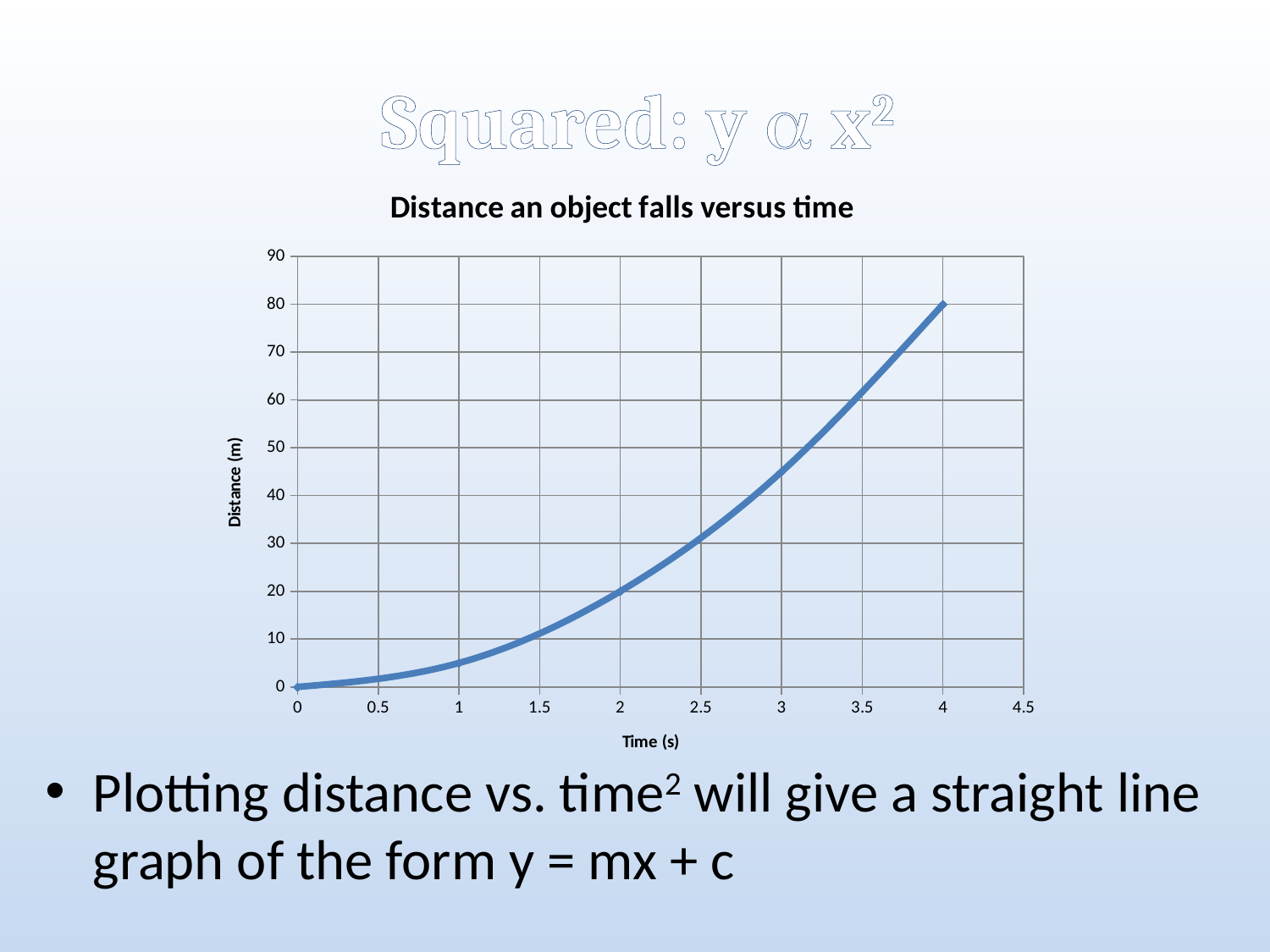
Does the distance rise or fall as time increases along the x axis? rise Which is larger, the distance at 2 s or the distance at 3 s? 3 s Is the distance at a time of 3 s greater or less than 50? less What is the label of the vertical axis? Distance (m) What kind of chart is shown on the slide? line chart At which time shown on the x axis is the distance highest? 4 What distance does the curve show at a time of 0 s? 0 Is the distance at a time of 1 s greater or less than 10? less What distance does the curve show at a time of 2 s? 20 What distance does the curve show at a time of 4 s? 80 What is the title of the chart? Distance an object falls versus time Is the distance at a time of 3 s greater or less than 40? greater